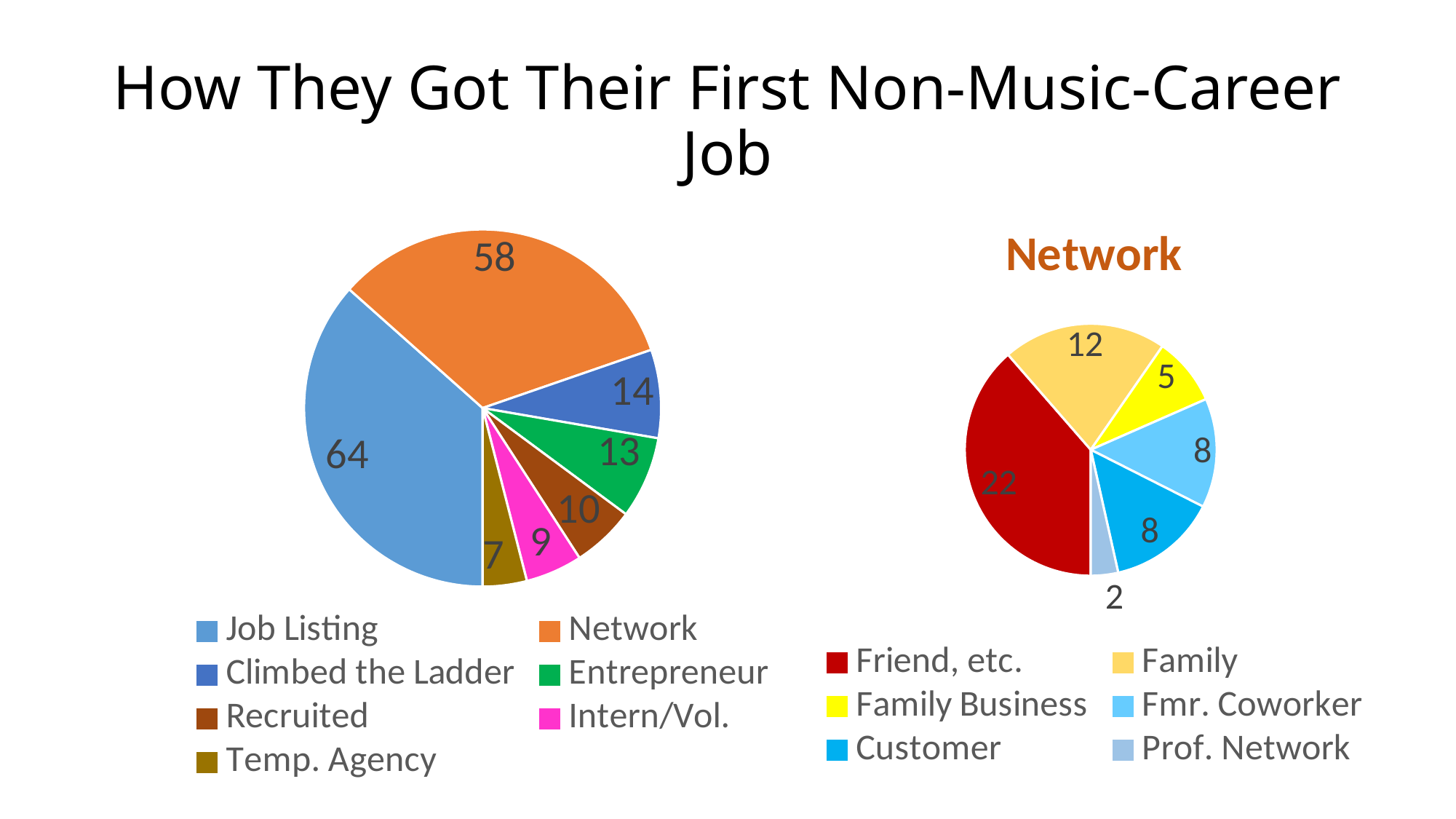
In the left pie chart, which is larger, Recruited or Intern/Vol.? Recruited In the left pie chart, which category has the largest slice? Job Listing How many categories does the Network pie chart show? 6 In the Network pie chart, what is the value for Prof. Network? 2 In the left pie chart, what is the difference between Job Listing and Network? 6 How many categories does the left pie chart show? 7 In the left pie chart, what is the value for Job Listing? 64 In the Network pie chart, what is the value for Friend, etc.? 22 In the left pie chart, which category has the smallest slice? Temp. Agency In the left pie chart, what is the value for Entrepreneur? 13 In the Network pie chart, what is the difference between Family and Family Business? 7 What type of chart is the Network chart on the right? Pie chart